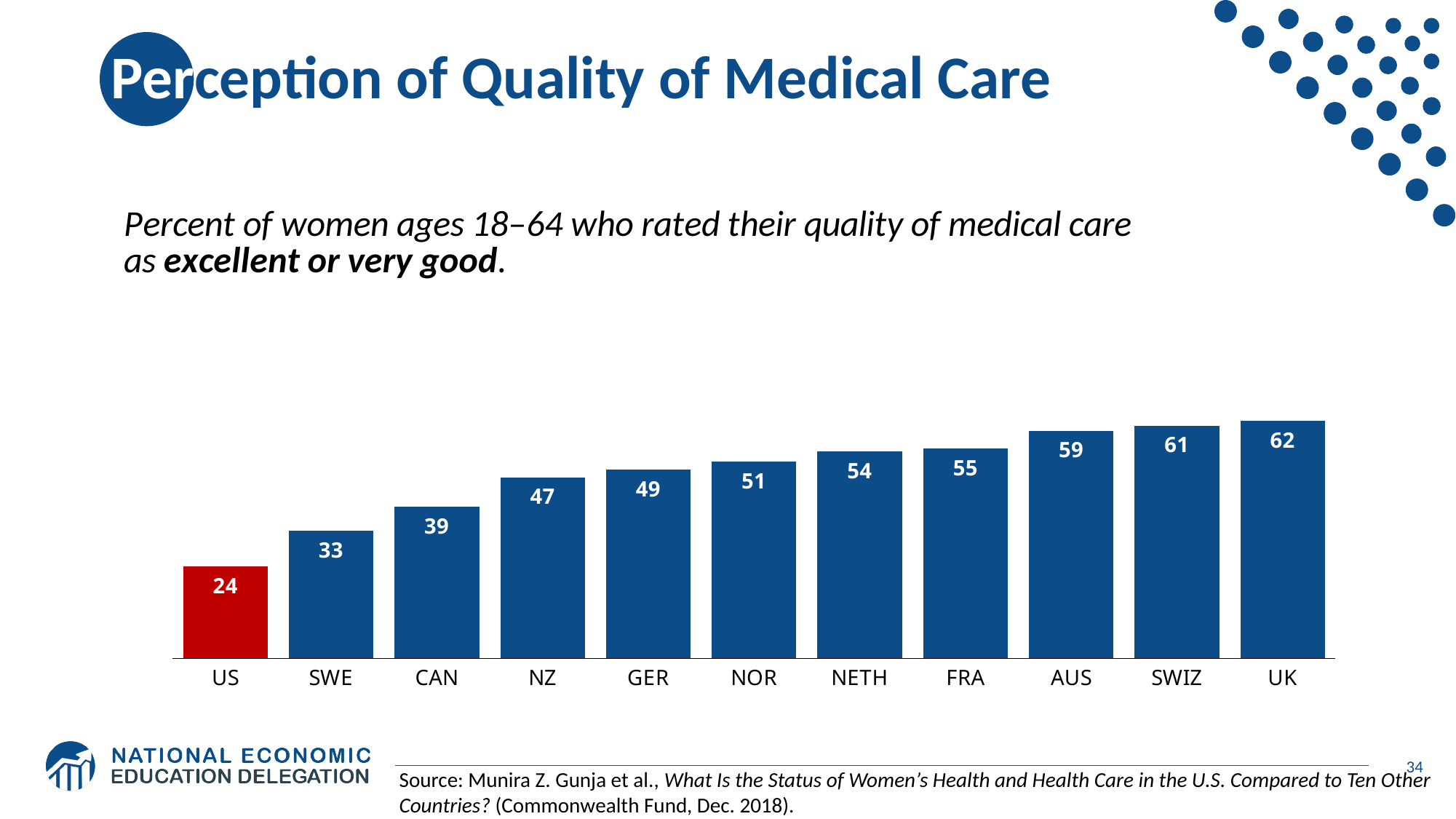
How many countries are shown in the chart? 11 Do the values rise or fall from left to right along the x axis? rise Which bar is coloured red rather than blue? US What kind of chart is shown on the slide? bar chart What is the value for AUS? 59 What is the value for GER? 49 Which country has the lowest value? US What is the difference between the values for UK and US? 38 Which has a larger value, SWE or NOR? NOR What is the difference between the values for NETH and CAN? 15 What is the value for the US? 24 Which country has the highest value? UK